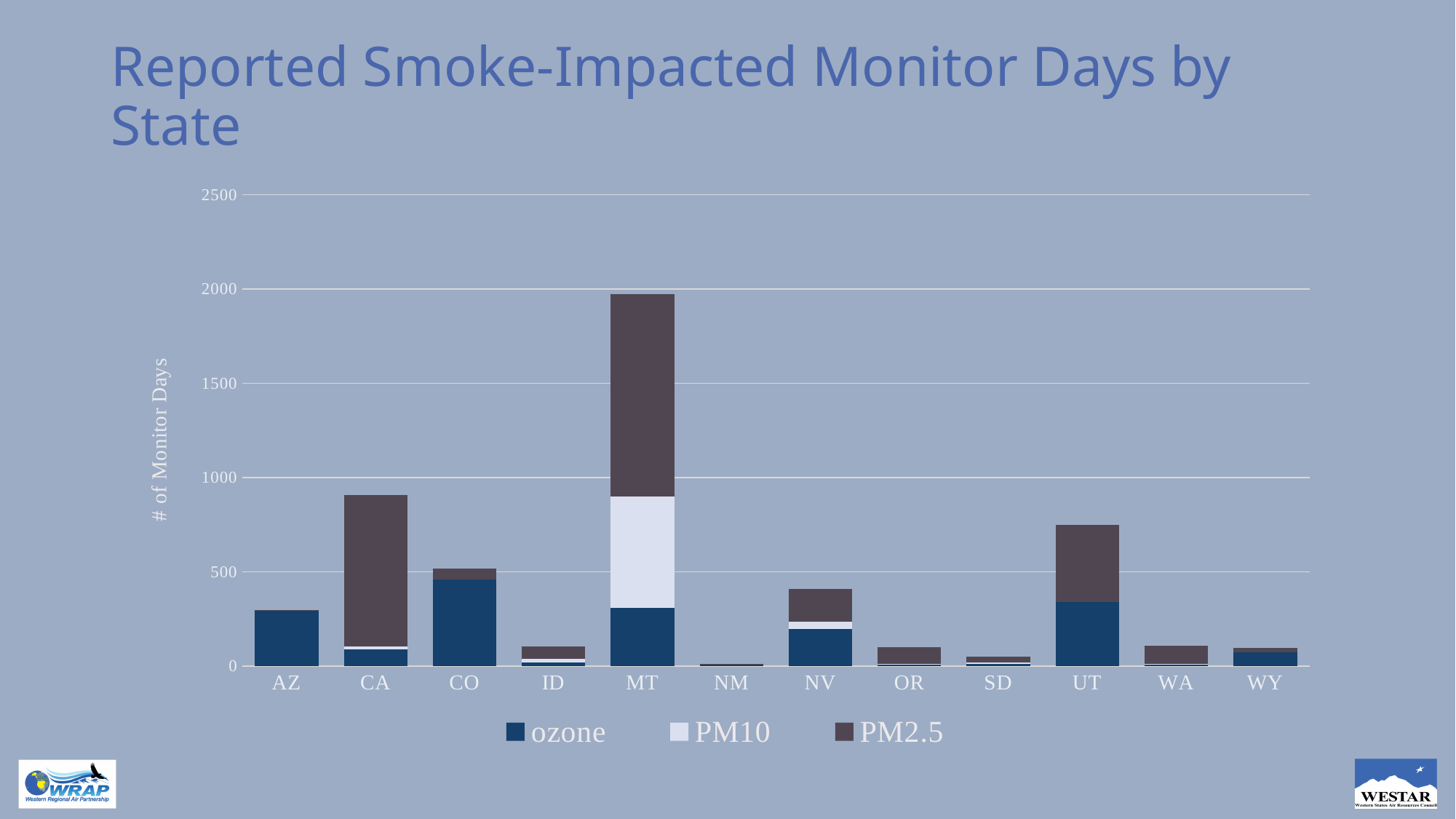
What is the label on the y axis of the chart? # of Monitor Days Is the total value for MT greater or less than 1500? greater Is the total value for CA greater or less than 1000? less Which state has the larger total of monitor days, CA or UT? CA Is the total value for AZ greater or less than 500? less What kind of chart is shown on the slide? Stacked bar chart Which state has the larger total of monitor days, AZ or NV? NV Which state has the lowest total number of smoke-impacted monitor days? NM How many series does the chart's legend list? 3 Which state has the highest total number of smoke-impacted monitor days? MT How many states are shown along the x axis of the chart? 12